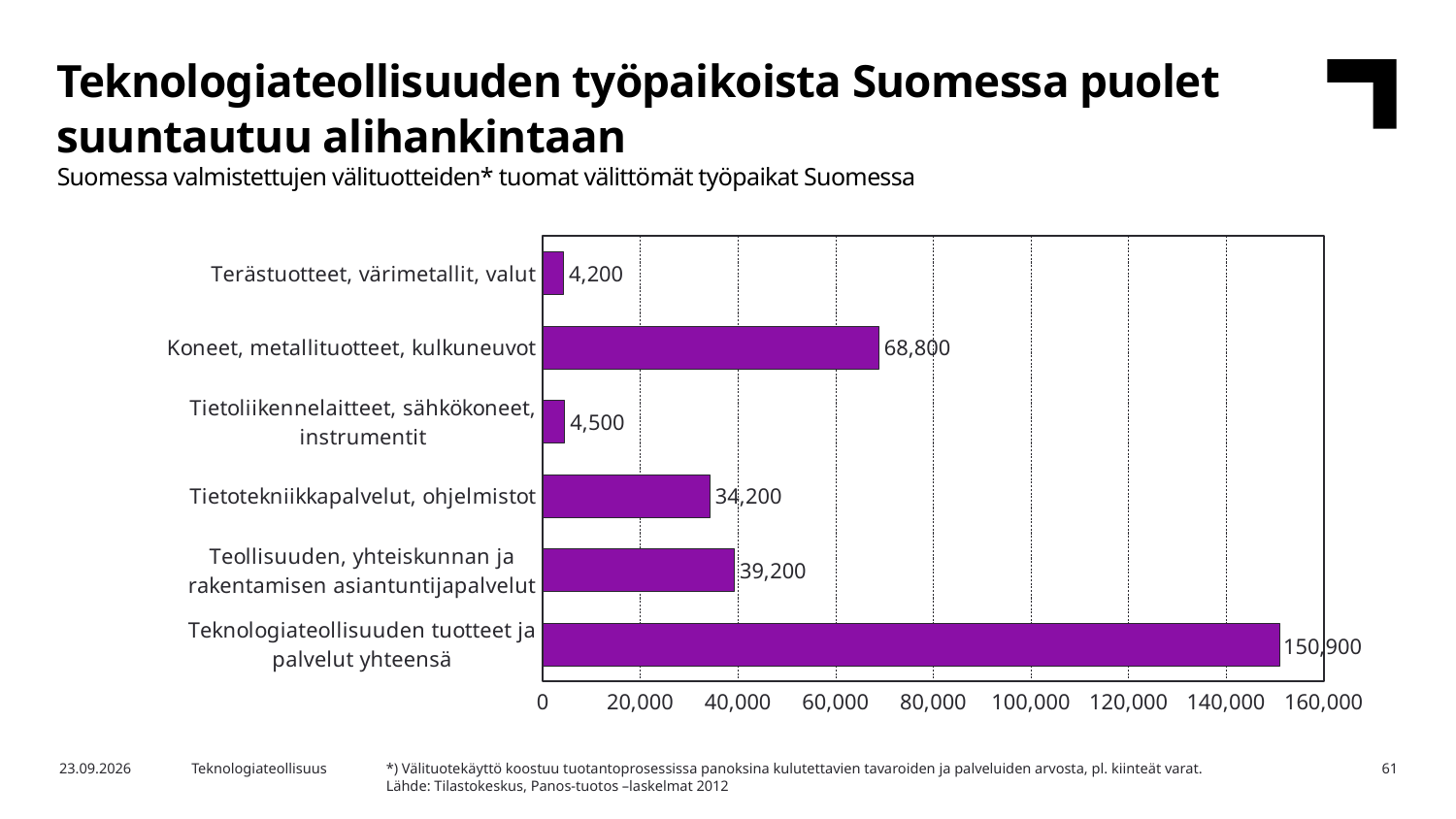
Which is larger: the value for Koneet, metallituotteet, kulkuneuvot or the value for Teollisuuden, yhteiskunnan ja rakentamisen asiantuntijapalvelut? Koneet, metallituotteet, kulkuneuvot What is the value for Tietotekniikkapalvelut, ohjelmistot? 34,200 Is the value for Koneet, metallituotteet, kulkuneuvot greater or less than 60,000? greater What kind of chart is shown on the slide? bar chart What is the value for Teknologiateollisuuden tuotteet ja palvelut yhteensä? 150,900 What is the value for Koneet, metallituotteet, kulkuneuvot? 68,800 How many categories are shown in the chart? 6 What is the value for Tietoliikennelaitteet, sähkökoneet, instrumentit? 4,500 What is the difference between the values for Teollisuuden, yhteiskunnan ja rakentamisen asiantuntijapalvelut and Tietotekniikkapalvelut, ohjelmistot? 5,000 Which category has the lowest value? Terästuotteet, värimetallit, valut What is the difference between the values for Tietoliikennelaitteet, sähkökoneet, instrumentit and Terästuotteet, värimetallit, valut? 300 Which category has the highest value? Teknologiateollisuuden tuotteet ja palvelut yhteensä